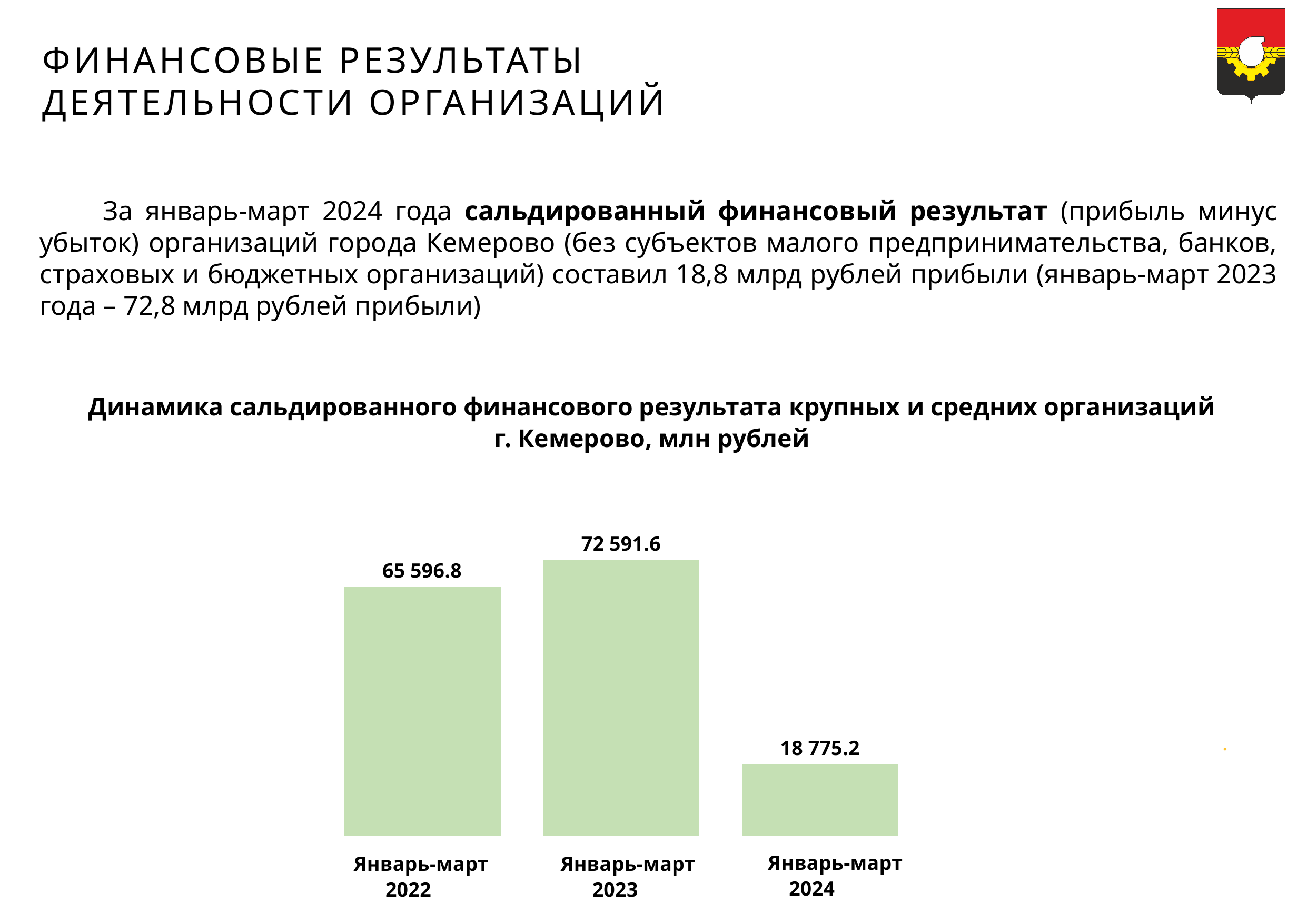
In what units are the chart values given, according to the chart title? млн рублей Which period has the lowest value? Январь-март 2024 Which period has the highest value? Январь-март 2023 What is the value for Январь-март 2023? 72 591.6 What is the difference between the values for Январь-март 2023 and Январь-март 2022? 6 994.8 What is the difference between the values for Январь-март 2023 and Январь-март 2024? 53 816.4 Which is larger, the value for Январь-март 2022 or Январь-март 2024? Январь-март 2022 What kind of chart is shown on the slide? Bar chart How many periods are shown in the chart? 3 What is the value for Январь-март 2022? 65 596.8 What is the value for Январь-март 2024? 18 775.2 Does the value rise or fall from Январь-март 2023 to Январь-март 2024? Falls